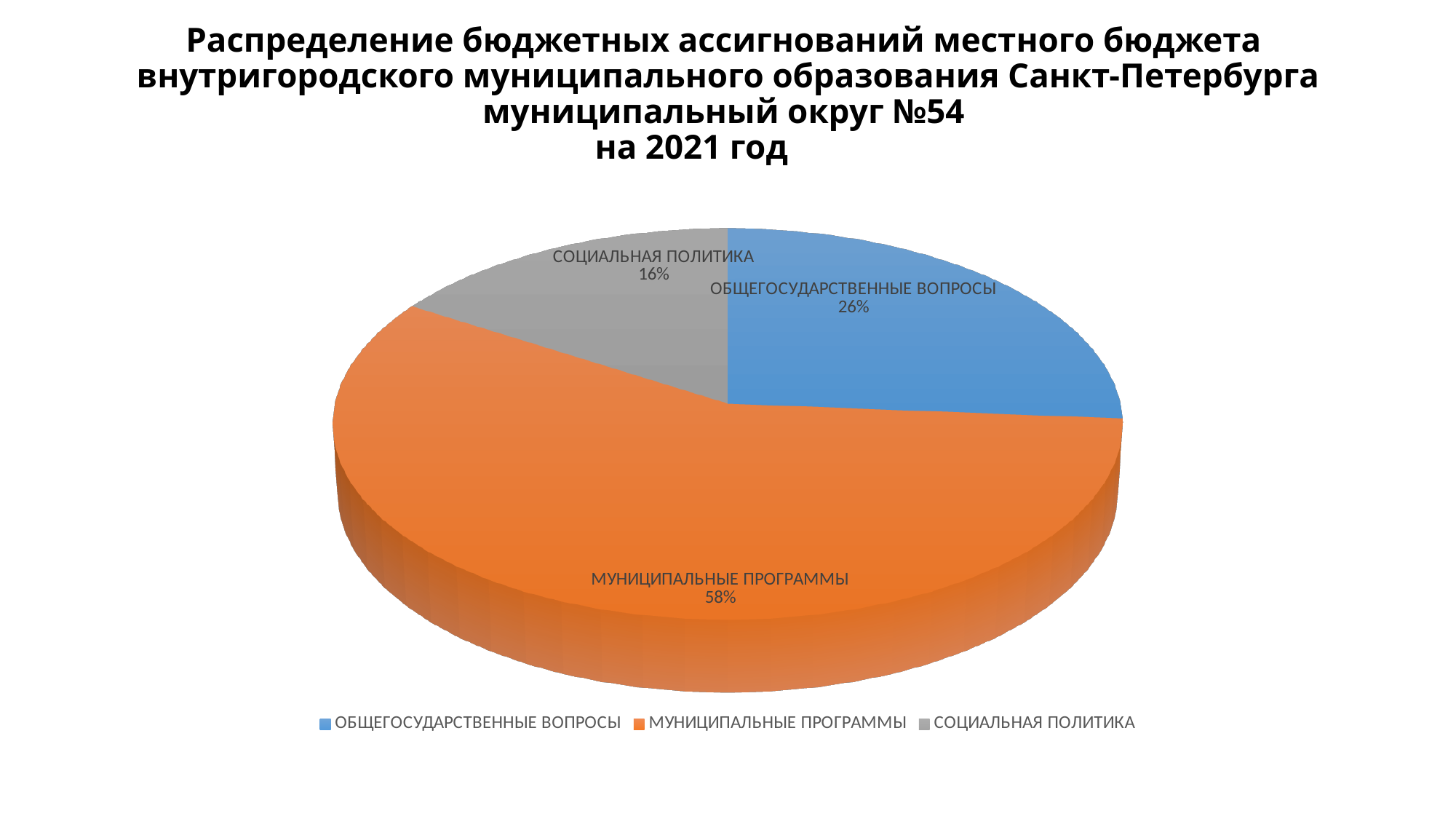
Which category has the smallest slice of the pie? СОЦИАЛЬНАЯ ПОЛИТИКА Which category has the largest slice of the pie? МУНИЦИПАЛЬНЫЕ ПРОГРАММЫ What colour is the slice for МУНИЦИПАЛЬНЫЕ ПРОГРАММЫ? Orange What kind of chart is shown on the slide? Pie chart How many categories are shown in the pie chart? 3 What share of the pie does ОБЩЕГОСУДАРСТВЕННЫЕ ВОПРОСЫ take? 26% How many entries does the legend list? 3 Which is larger: the share for ОБЩЕГОСУДАРСТВЕННЫЕ ВОПРОСЫ or for СОЦИАЛЬНАЯ ПОЛИТИКА? ОБЩЕГОСУДАРСТВЕННЫЕ ВОПРОСЫ What is the difference in percentage points between МУНИЦИПАЛЬНЫЕ ПРОГРАММЫ and ОБЩЕГОСУДАРСТВЕННЫЕ ВОПРОСЫ? 32 What share of the pie does МУНИЦИПАЛЬНЫЕ ПРОГРАММЫ take? 58% What share of the pie does СОЦИАЛЬНАЯ ПОЛИТИКА take? 16% What is the difference in percentage points between ОБЩЕГОСУДАРСТВЕННЫЕ ВОПРОСЫ and СОЦИАЛЬНАЯ ПОЛИТИКА? 10